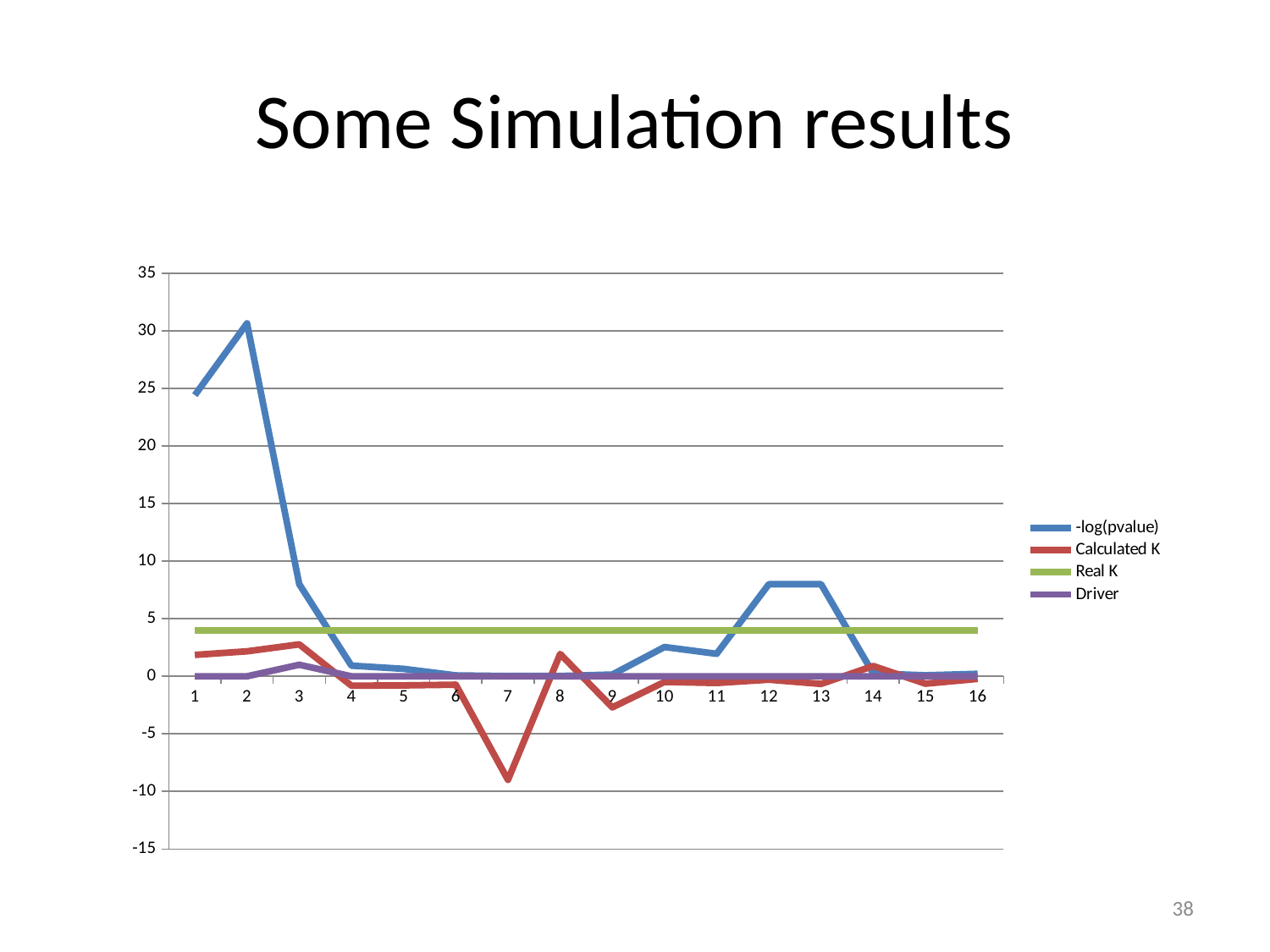
Is the value of -log(pvalue) at point 12 greater or less than 5? greater How many points are plotted along the x axis? 16 Is the value of Calculated K at point 7 greater or less than -5? less At which x-axis point does the Calculated K series reach its lowest value? 7 At which x-axis point does the -log(pvalue) series reach its highest value? 2 Is the value of the Real K series greater or less than 5? less Which series is drawn in green in the legend? Real K Does the -log(pvalue) series rise or fall from point 2 to point 4? fall At point 2, which is larger: -log(pvalue) or Calculated K? -log(pvalue) How many series does the legend list? 4 What kind of chart is shown on the slide? line chart